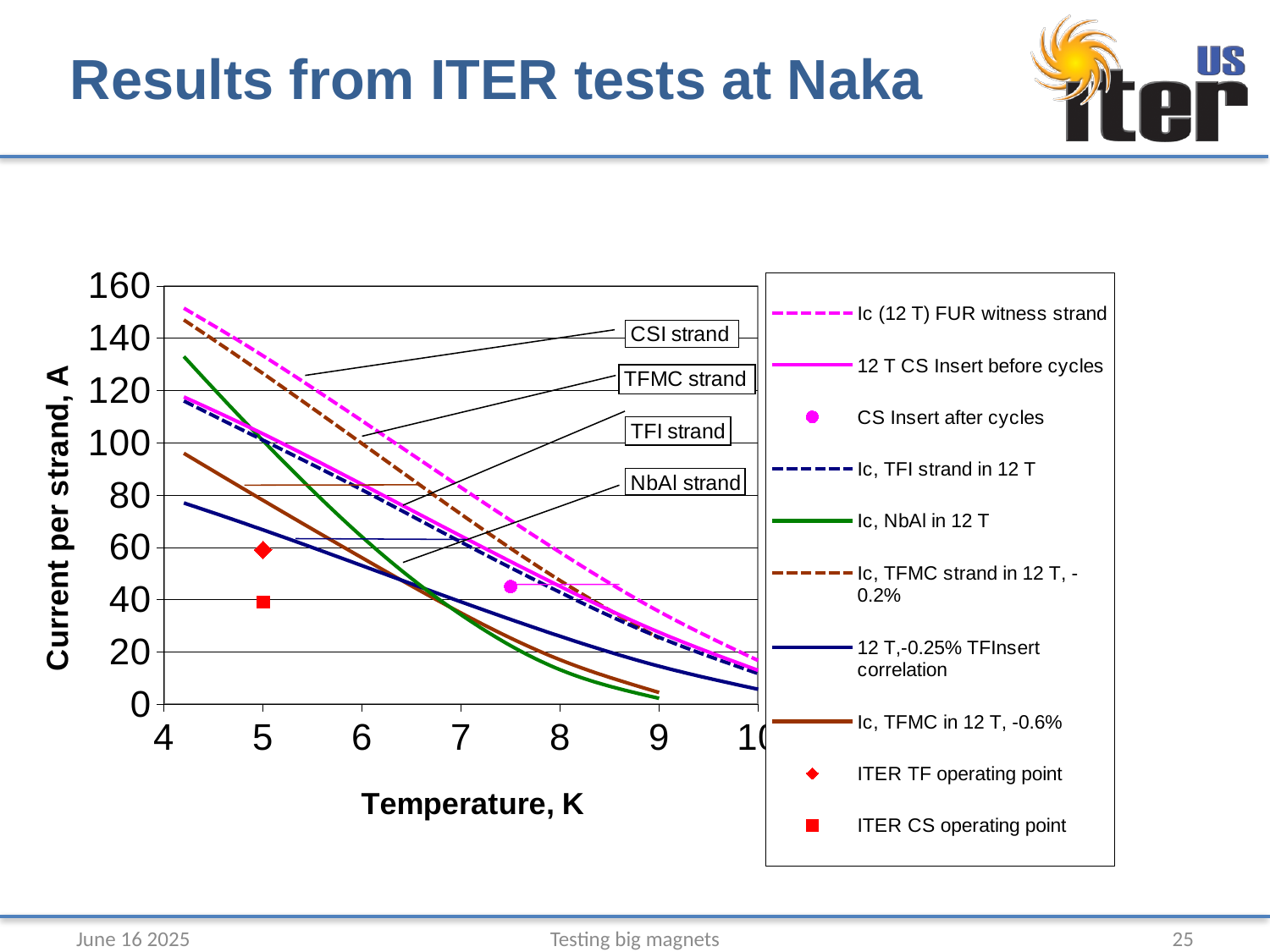
What is the label of the horizontal axis of the chart? Temperature, K At 5 K, which is larger: the Ic (12 T) FUR witness strand curve or the Ic, NbAl in 12 T curve? Ic (12 T) FUR witness strand What kind of chart is shown on the slide? line chart How many entries does the chart legend list? 10 Is the value of the ITER CS operating point greater or less than 20 A? greater What is the maximum value shown on the vertical axis of the chart? 160 What is the label of the vertical axis of the chart? Current per strand, A Is the value of the CS Insert after cycles point greater or less than 60 A? less Is the value of the Ic, NbAl in 12 T curve at 4 K greater or less than 120 A? greater Which is larger at 5 K: the ITER TF operating point or the ITER CS operating point? ITER TF operating point Do the current-per-strand curves rise or fall as temperature increases along the x axis? fall